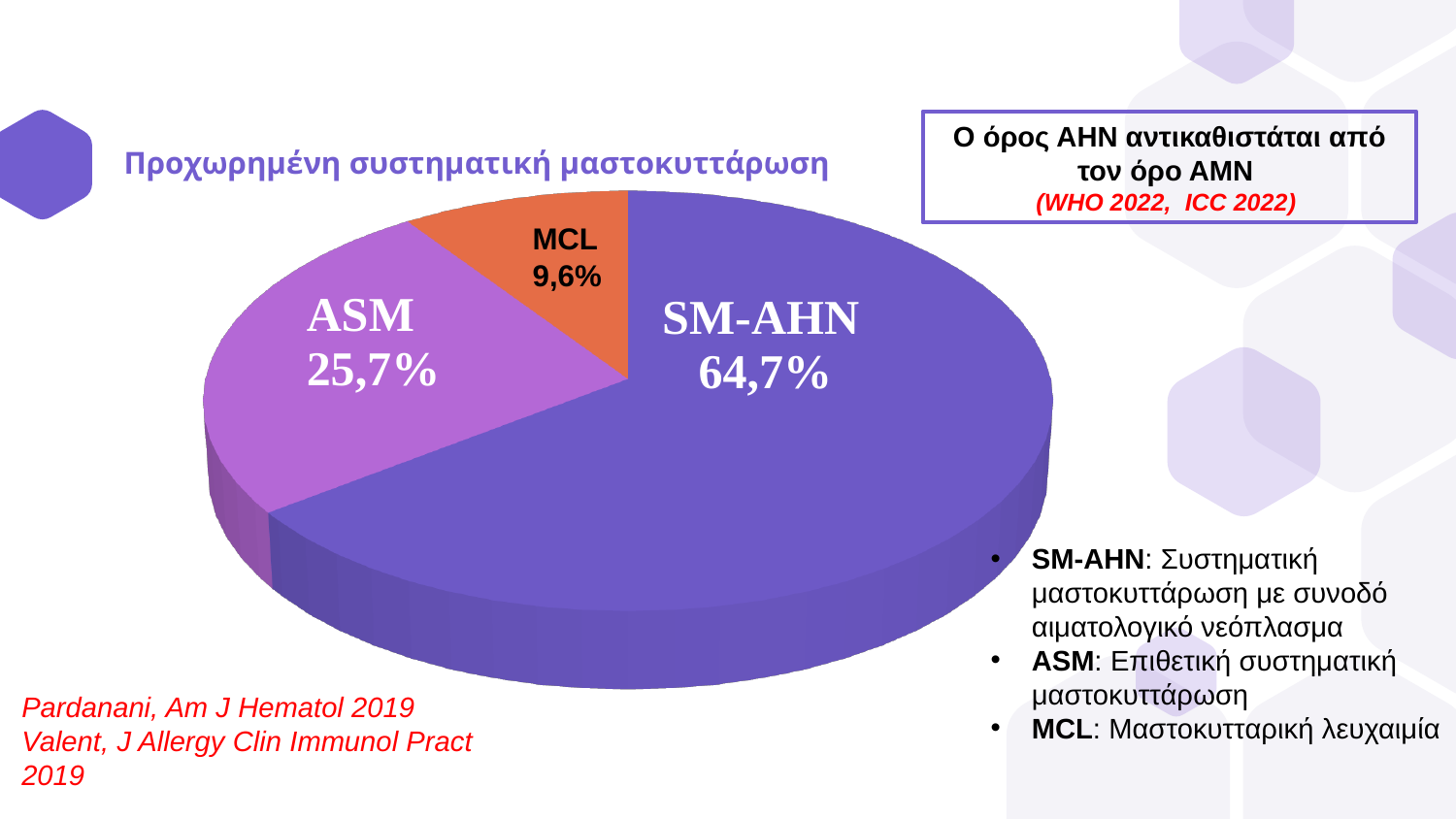
Which category has the smallest slice of the pie chart? MCL What is the difference in percentage points between SM-AHN and ASM? 39,0% What percentage of the pie chart is ASM? 25,7% What colour is the MCL slice of the pie chart? orange What percentage of the pie chart is MCL? 9,6% What kind of chart is shown on the slide? pie chart What is the title of the pie chart? Προχωρημένη συστηματική μαστοκυττάρωση How many slices does the pie chart have? 3 What percentage of the pie chart is SM-AHN? 64,7% Which is larger, the share for ASM or the share for MCL? ASM What is the difference in percentage points between ASM and MCL? 16,1% Which category has the largest slice of the pie chart? SM-AHN